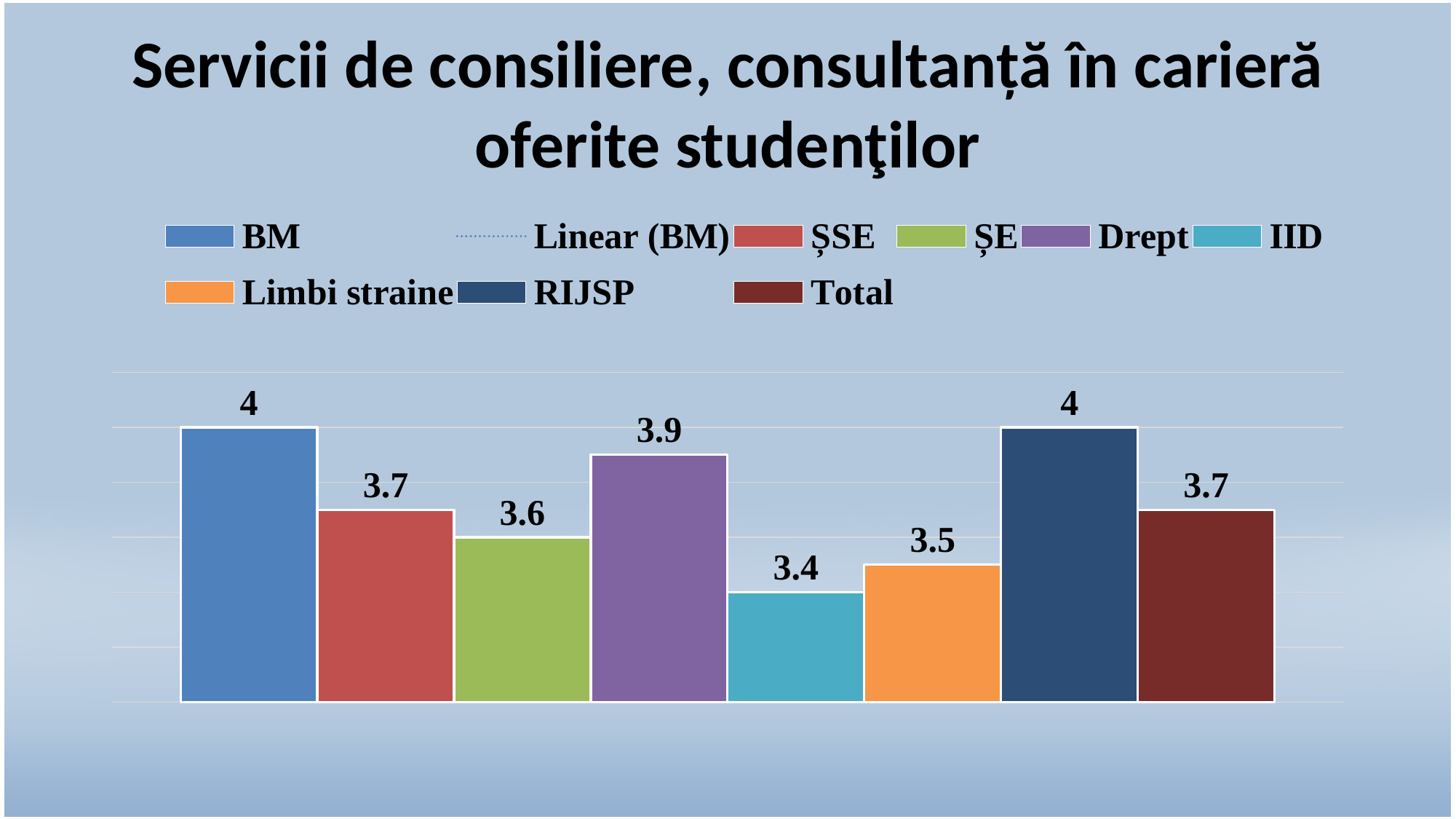
What kind of chart is shown on the slide? Bar chart How many entries does the legend list? 9 Which is larger, the value for ȘSE or the value for Limbi straine? ȘSE Which two categories share the highest value of 4? BM and RIJSP What is the value for IID? 3.4 Which category has the lowest value? IID How many bars are plotted in the chart? 8 What is the value for Drept? 3.9 What is the difference between the values for Drept and ȘE? 0.3 What is the value for BM? 4 What is the value for Total? 3.7 What is the value for Limbi straine? 3.5